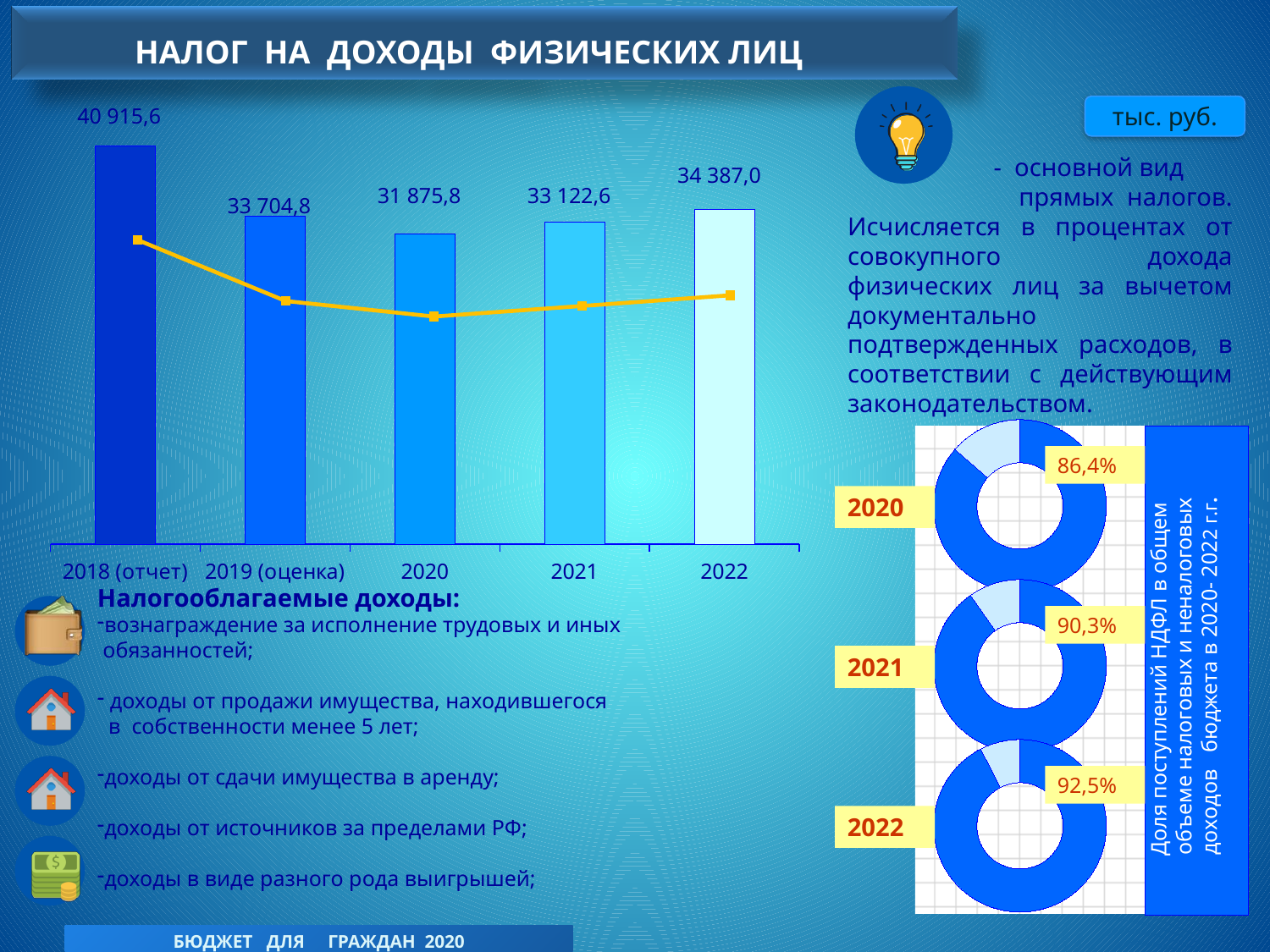
In the bar chart on the left, what is the difference between the values for 2018 (отчет) and 2019 (оценка)? 7 210,8 In the bar chart on the left, what is the value for 2018 (отчет)? 40 915,6 How many years (categories) are shown in the bar chart on the left? 5 In the doughnut charts on the right, what is the share of НДФЛ shown for 2021? 90,3% In the bar chart on the left, what is the difference between the values for 2022 and 2020? 2 511,2 In the bar chart on the left, what is the value for 2022? 34 387,0 In the bar chart on the left, which year has the lowest value? 2020 In the bar chart on the left, which year has the highest value? 2018 (отчет) In the doughnut charts on the right, what is the difference between the share for 2022 and the share for 2020? 6,1% In the bar chart on the left, which is larger: the value for 2021 or the value for 2019 (оценка)? 2019 (оценка) In the bar chart on the left, do the values rise or fall from 2020 to 2022? rise In the bar chart on the left, what is the value for 2020? 31 875,8